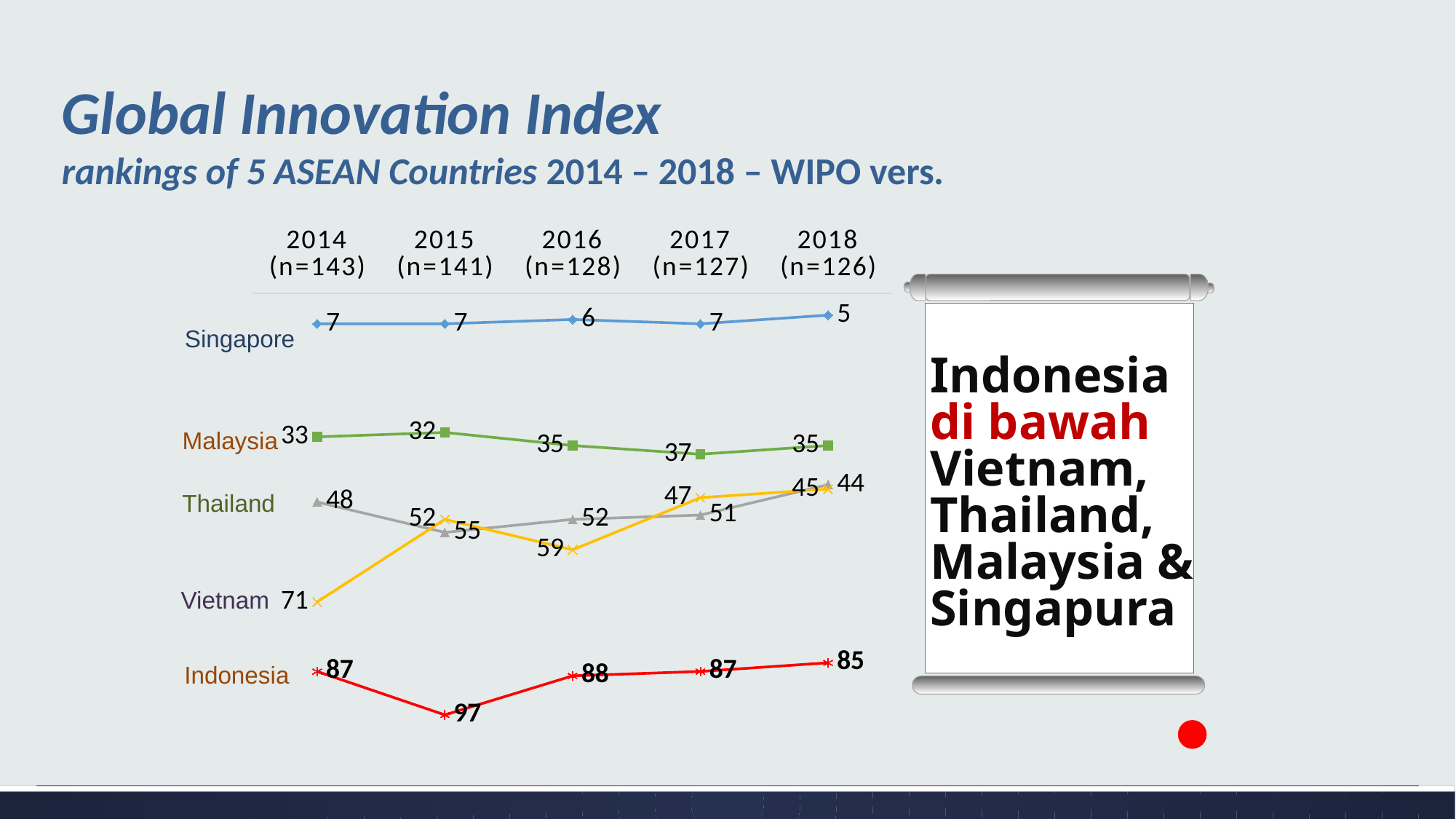
How many years (x-axis points) are plotted in the chart? 5 What is Malaysia's ranking in 2016? 35 What is Indonesia's Global Innovation Index ranking in 2015? 97 Which country has the largest ranking number in 2018? Indonesia What is the difference between Indonesia's and Vietnam's ranking numbers in 2018? 40 What is Singapore's ranking in 2018? 5 What is Thailand's ranking in 2017? 51 What type of chart is shown on the slide? line chart What is Vietnam's ranking in 2014? 71 Which has the larger ranking number in 2015, Thailand or Vietnam? Thailand How many countries (series) are plotted in the chart? 5 Which country has the smallest ranking number in 2014? Singapore